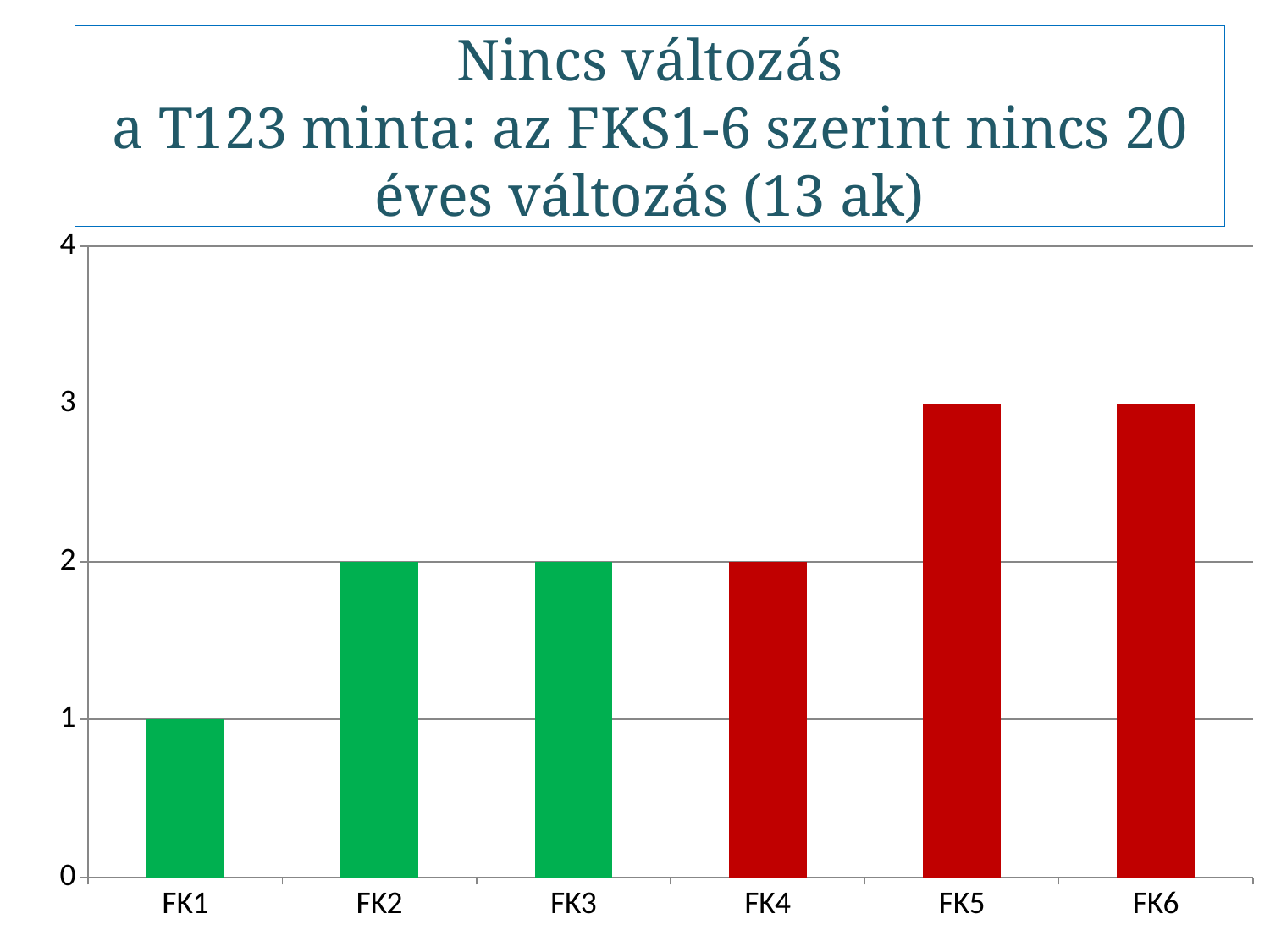
How many categories are shown on the x axis? 6 Which is larger, the value for FK1 or the value for FK4? FK4 Do the values generally rise or fall from FK1 to FK6? rise Which category has the lowest value? FK1 What is the value for FK5? 3 What is the difference between the values for FK5 and FK4? 1 What kind of chart is shown on the slide? bar chart What colour are the bars for FK4, FK5 and FK6? red What is the value for FK3? 2 What is the value for FK1? 1 Which is larger, the value for FK2 or the value for FK6? FK6 What is the difference between the values for FK6 and FK1? 2